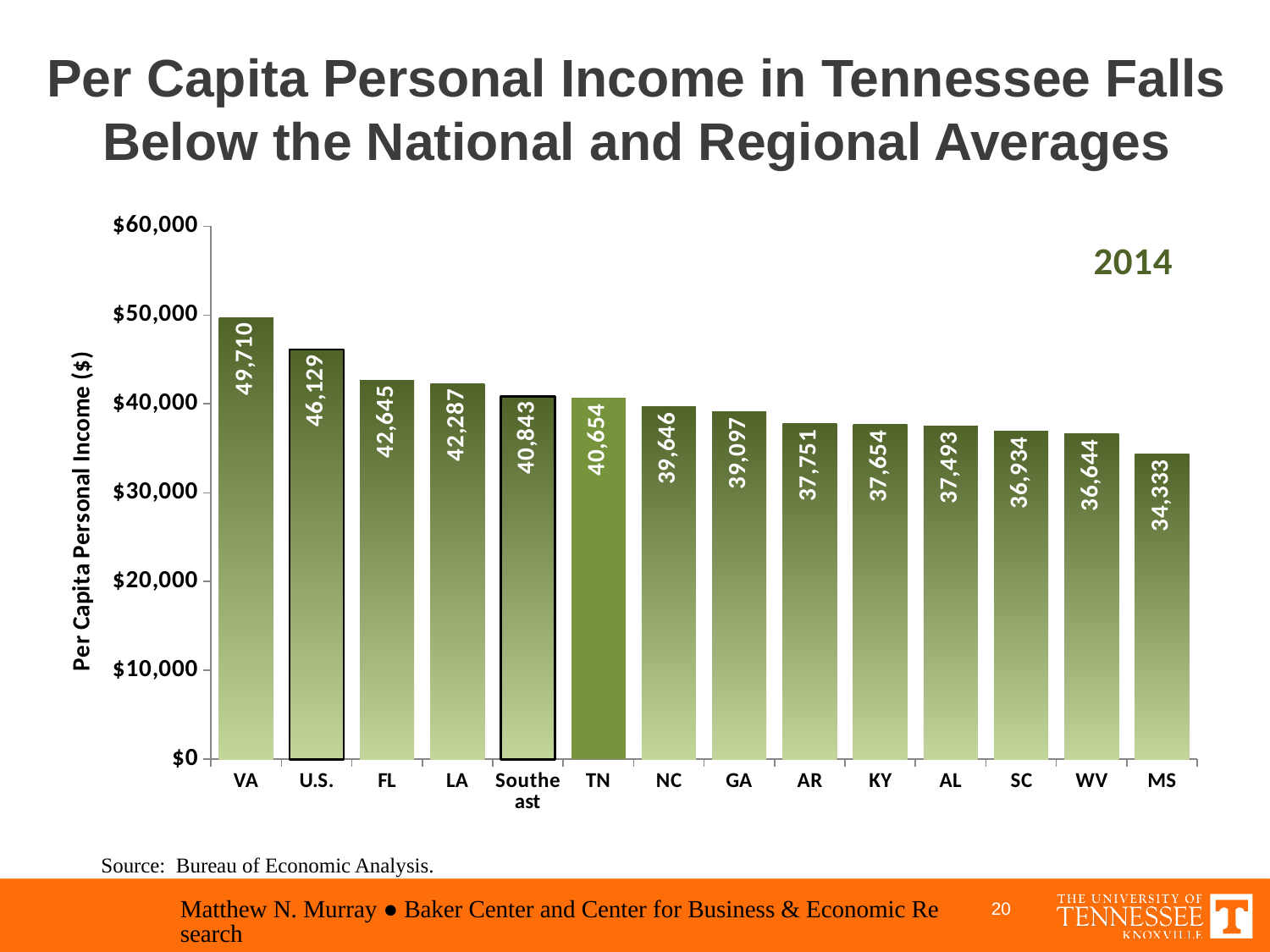
What is the difference between the VA value and the MS value? 15,377 What year is labeled on the chart? 2014 What is the difference between the U.S. value and the TN value? 5,475 Which is larger, the value for FL or the value for LA? FL Which category has the highest per capita personal income? VA How many categories are shown on the x axis? 14 What is the value shown for the Southeast bar? 40,843 What is the value shown for the U.S. bar? 46,129 Is the value for NC greater or less than $40,000? less What is the per capita personal income value shown for TN? 40,654 What kind of chart is shown on the slide? bar chart Which category has the lowest per capita personal income? MS